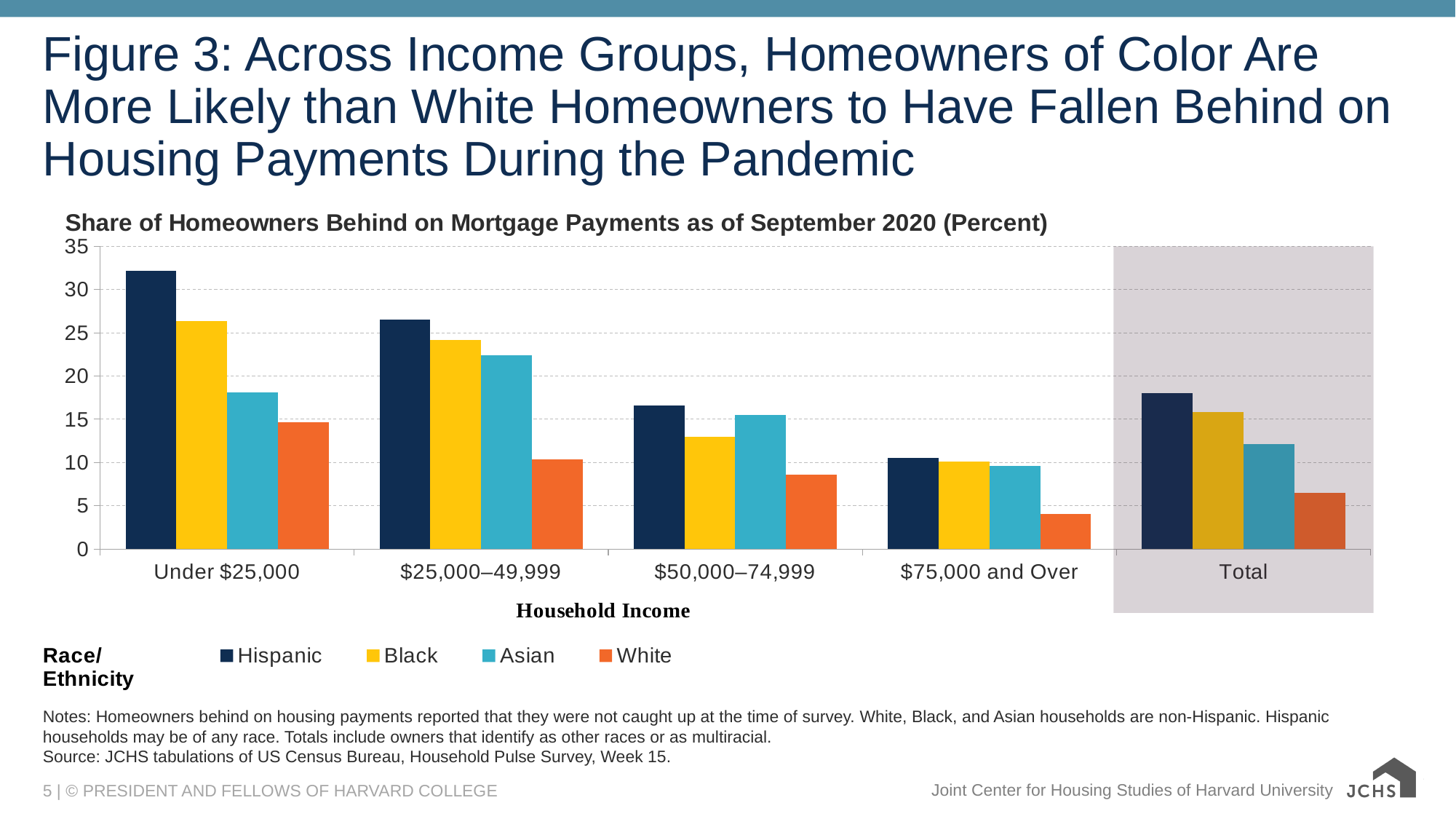
How many household income categories (including Total) are shown on the x axis? 5 What kind of chart is shown on the slide? bar chart Is the value for Black homeowners in the $25,000–49,999 group greater or less than 20? greater How many race/ethnicity series does the legend list? 4 Which race/ethnicity series is shown in dark navy in the legend? Hispanic Is the value for White homeowners in the $75,000 and Over group greater or less than 5? less What is the title of the chart? Share of Homeowners Behind on Mortgage Payments as of September 2020 (Percent) Which household income group has the highest share of Hispanic homeowners behind on mortgage payments? Under $25,000 Is the value for Hispanic homeowners in the Under $25,000 group greater or less than 30? greater Which household income group has the lowest share of White homeowners behind on mortgage payments? $75,000 and Over Moving from Under $25,000 to $75,000 and Over, do the values for Hispanic homeowners rise or fall? fall In the $50,000–74,999 group, which is larger: the share for Asian homeowners or for Black homeowners? Asian